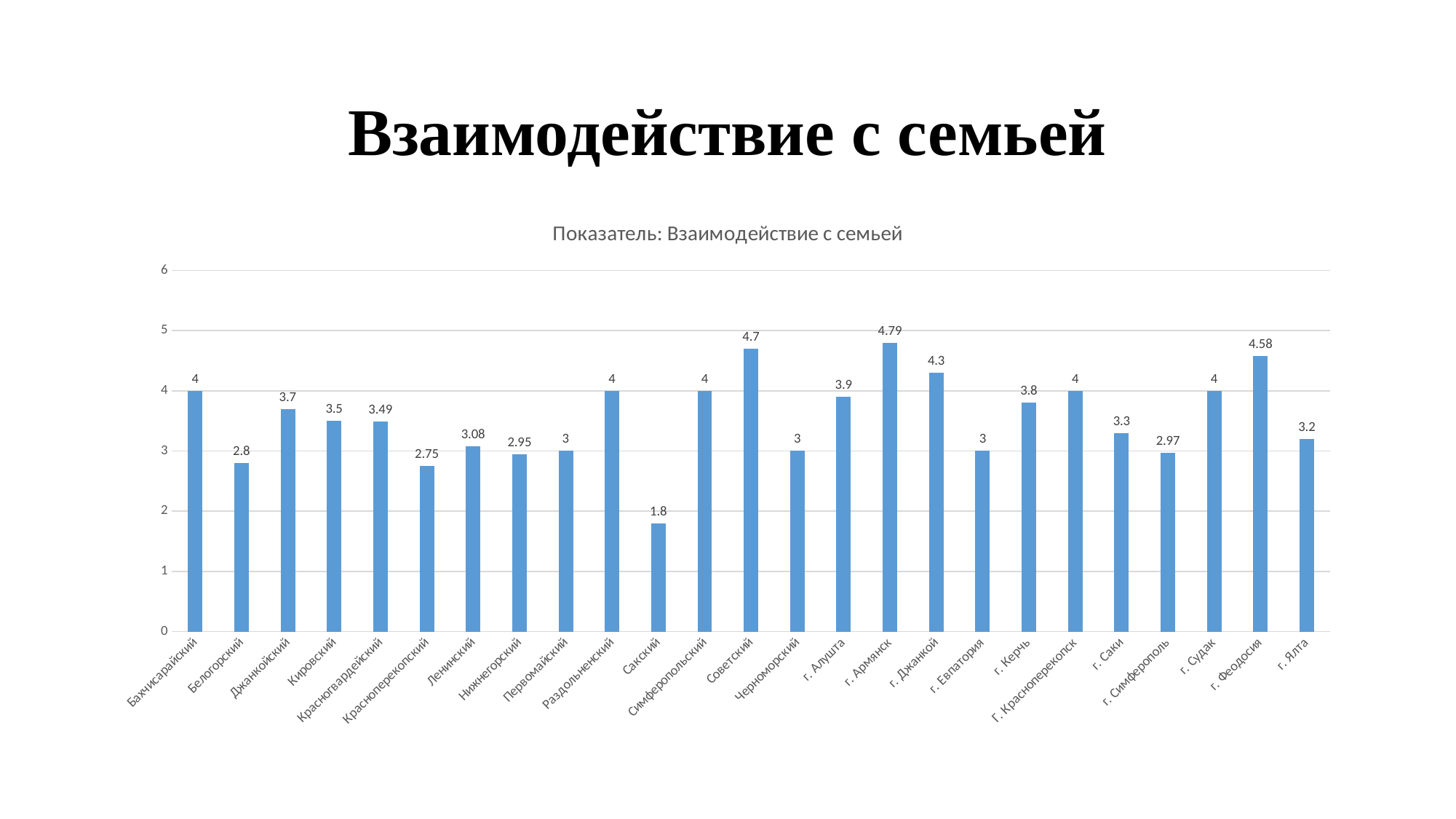
What kind of chart is shown on the slide? bar chart What is the value for Красногвардейский? 3.49 What is the title of the chart? Показатель: Взаимодействие с семьей What is the difference between the values for г. Армянск and Сакский? 2.99 Which category has the highest value? г. Армянск Which category has the lowest value? Сакский Is the value for Белогорский greater or less than 3? less What is the value for Сакский? 1.8 What is the value for Советский? 4.7 Which is larger, the value for г. Джанкой or the value for г. Керчь? г. Джанкой What is the value for г. Феодосия? 4.58 How many categories are shown on the x axis? 25